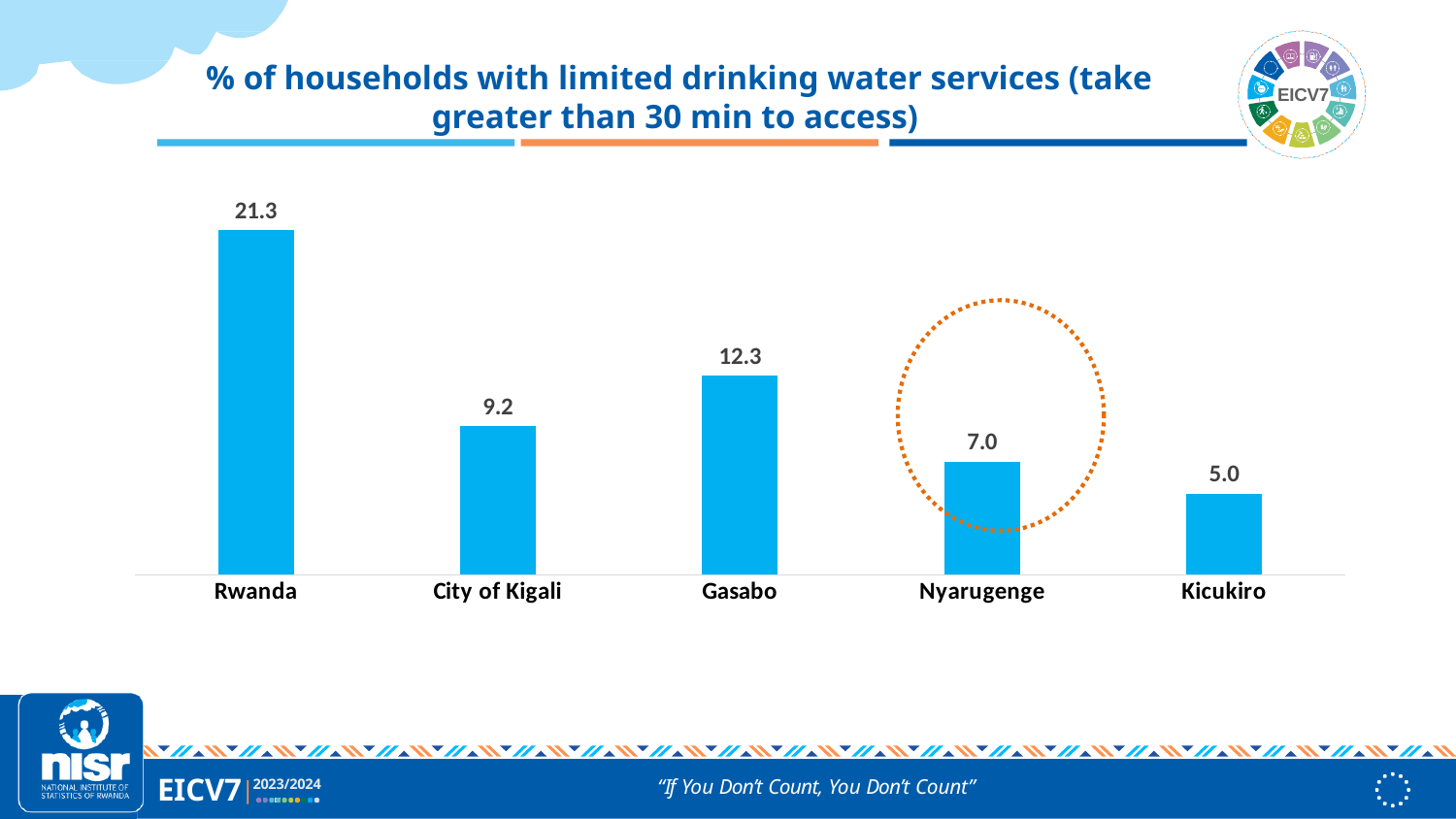
What is the value for Gasabo? 12.3 What is the value for Rwanda? 21.3 What is the value for Nyarugenge? 7.0 Which is larger, the value for Gasabo or the value for Kicukiro? Gasabo Which category has the highest value? Rwanda What is the difference between the values for Rwanda and City of Kigali? 12.1 What is the difference between the values for Gasabo and Nyarugenge? 5.3 What is the value for Kicukiro? 5.0 Which category has the lowest value? Kicukiro How many categories are shown on the chart? 5 What kind of chart is shown on the slide? Bar chart What is the value for City of Kigali? 9.2